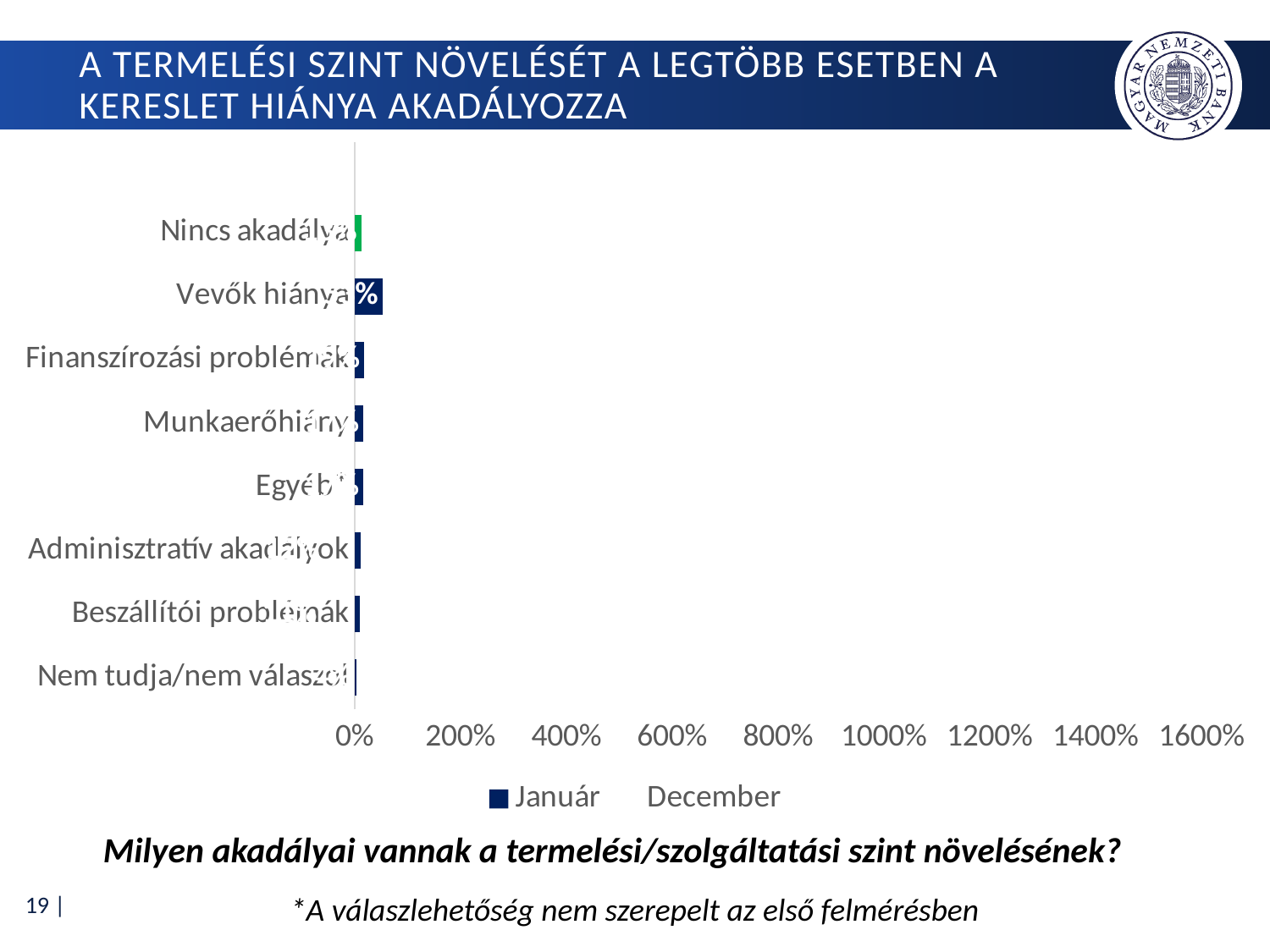
Which has the longer bar, Vevők hiánya or Beszállítói problémák? Vevők hiánya Is the value for Vevők hiánya greater or less than 200%? less What are the two series named in the chart legend? Január and December Which category is listed first (at the top) of the chart's vertical axis? Nincs akadálya Which category has the shortest bar in the chart? Nem tudja/nem válaszol Which has the longer bar, Vevők hiánya or Nincs akadálya? Vevők hiánya Is the value for Finanszírozási problémák greater or less than 400%? less What kind of chart is shown on the slide? bar chart How many categories are listed on the vertical axis of the chart? 8 What is the highest value shown on the horizontal axis of the chart? 1600% Which category has the longest bar in the chart? Vevők hiánya How many series does the chart legend list? 2